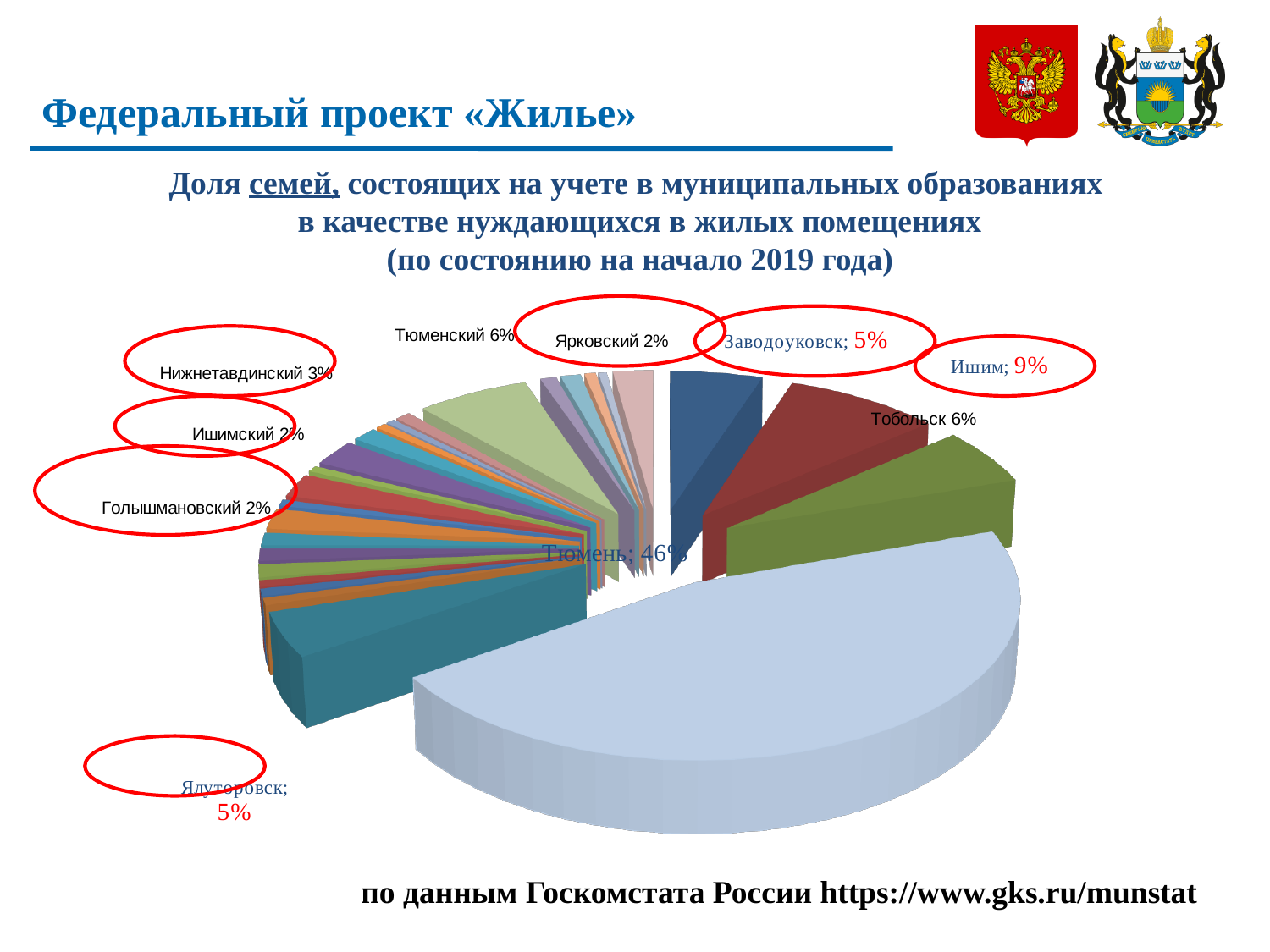
What is the value shown for Заводоуковск? 5% Which labelled category has the largest slice of the pie? Тюмень What is the value shown for Ишим? 9% What is the value shown for Тюменский? 6% What is the value shown for Тобольск? 6% What share of the pie does Тюмень hold? 46% What kind of chart is shown on the slide? pie chart According to the chart title, as of the start of which year are the data given? 2019 What is the value shown for Нижнетавдинский? 3% Which is larger, the slice for Ишим or the slice for Тобольск? Ишим What is the difference between the values for Тюмень and Ишим? 37% What is the value shown for Ялуторовск? 5%